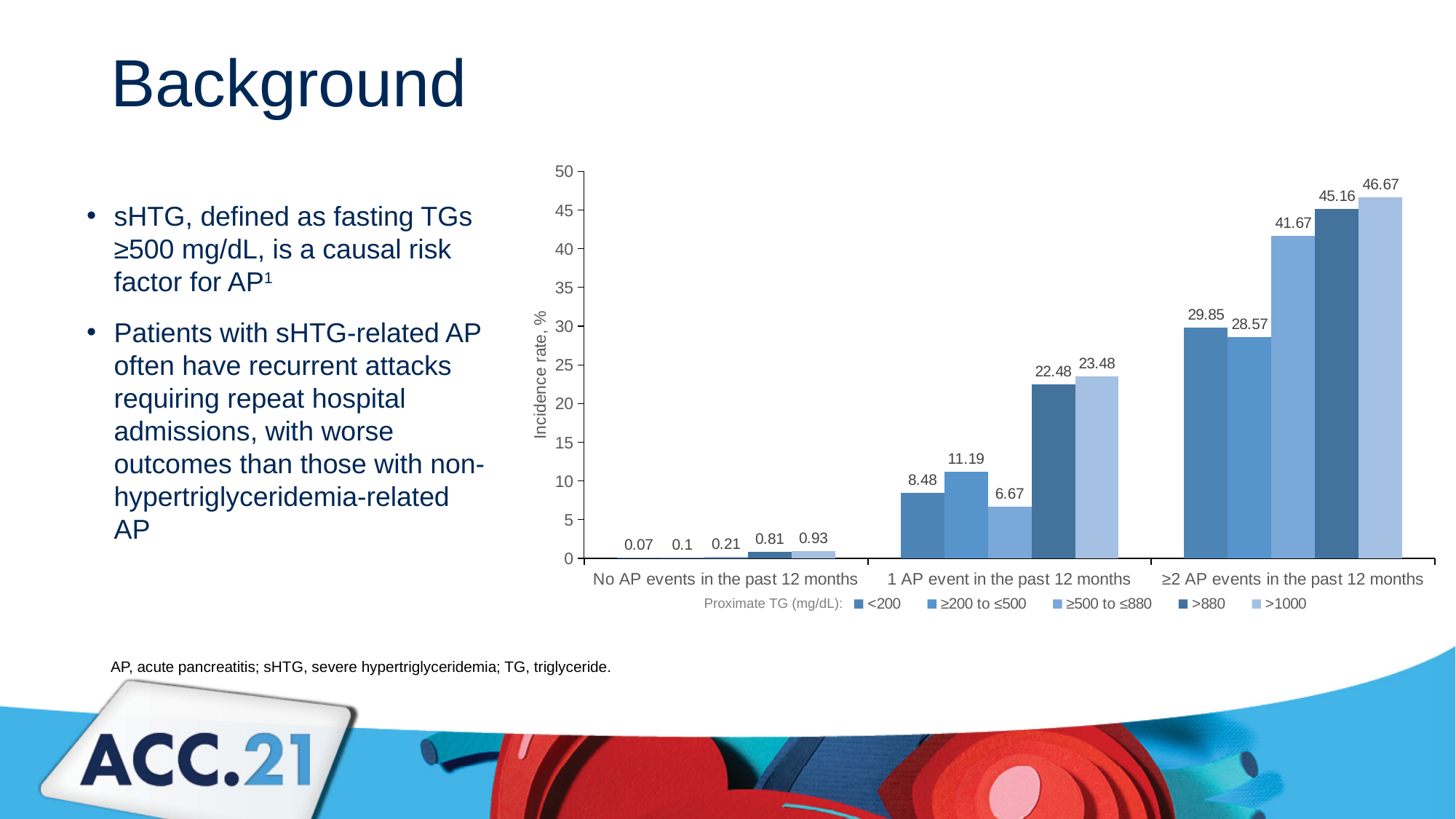
Which TG group has the highest incidence rate among patients with ≥2 AP events in the past 12 months? >1000 What is the incidence rate for the >880 mg/dL TG group among patients with no AP events in the past 12 months? 0.81 What is the label of the y axis? Incidence rate, % How many TG groups does the legend list? 5 Which TG group has the lowest incidence rate among patients with 1 AP event in the past 12 months? ≥500 to ≤880 How many AP event categories are shown on the x axis? 3 Is the incidence rate for the >880 group among patients with 1 AP event in the past 12 months greater or less than 20? greater What is the incidence rate for the >1000 mg/dL TG group among patients with ≥2 AP events in the past 12 months? 46.67 What type of chart is shown on the slide? Bar chart Among patients with ≥2 AP events in the past 12 months, which has the higher incidence rate: the <200 group or the ≥200 to ≤500 group? <200 What is the difference in incidence rate between the >1000 and <200 TG groups among patients with ≥2 AP events in the past 12 months? 16.82 What is the incidence rate for the ≥200 to ≤500 mg/dL TG group among patients with 1 AP event in the past 12 months? 11.19